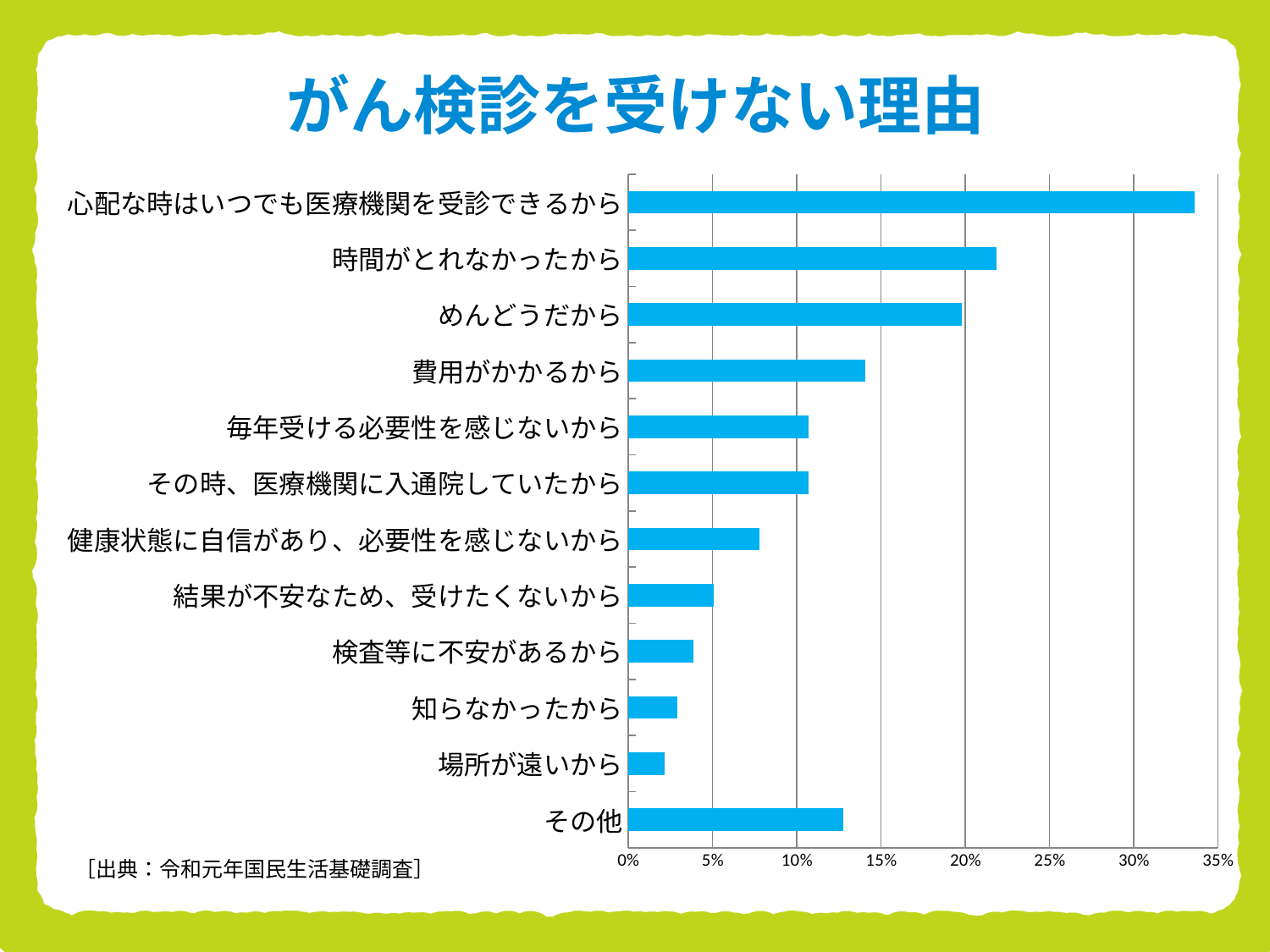
Which reason has the highest value? 心配な時はいつでも医療機関を受診できるから Is the value for 検査等に不安があるから greater or less than 5%? less What is the title of the chart? がん検診を受けない理由 Is the value for その他 greater or less than 10%? greater Is the value for 心配な時はいつでも医療機関を受診できるから greater or less than 30%? greater Which reason has the lowest value? 場所が遠いから What kind of chart is shown on the slide? bar chart How many categories (reasons) are plotted in the chart? 12 Which is larger, the value for 費用がかかるから or the value for その他? 費用がかかるから Which is larger, the value for 時間がとれなかったから or the value for めんどうだから? 時間がとれなかったから